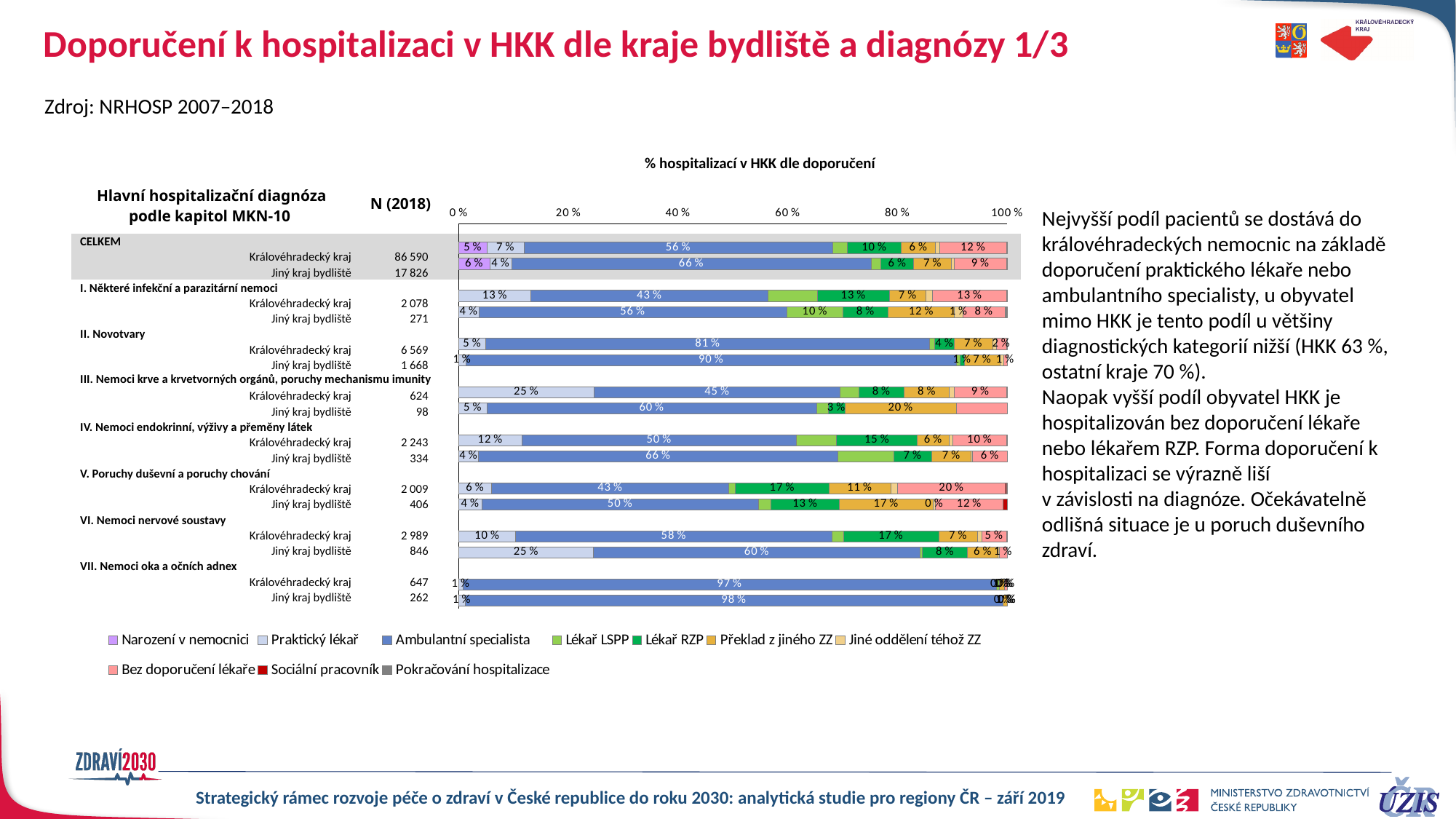
For V. Poruchy duševní a poruchy chování, Královéhradecký kraj, what is the Bez doporučení lékaře share? 20 % In the CELKEM row for Jiný kraj bydliště, what percentage of hospitalizations were recommended by an Ambulantní specialista? 66 % In the CELKEM row for Královéhradecký kraj, what percentage of hospitalizations were recommended by an Ambulantní specialista? 56 % For VII. Nemoci oka a očních adnex, Královéhradecký kraj, what is the Ambulantní specialista share? 97 % Which bar has the highest Ambulantní specialista share in the chart? VII. Nemoci oka a očních adnex, Jiný kraj bydliště (98 %) For II. Novotvary, Jiný kraj bydliště, what is the Ambulantní specialista share? 90 % For III. Nemoci krve a krvetvorných orgánů, Královéhradecký kraj, what is the Praktický lékař share? 25 % How many series does the chart legend list? 10 What is the title of the chart? % hospitalizací v HKK dle doporučení In the CELKEM rows, how many percentage points higher is the Ambulantní specialista share for Jiný kraj bydliště than for Královéhradecký kraj? 10 percentage points What type of chart is shown on the slide? Stacked bar chart For II. Novotvary, which residence group has the larger Ambulantní specialista share: Královéhradecký kraj or Jiný kraj bydliště? Jiný kraj bydliště